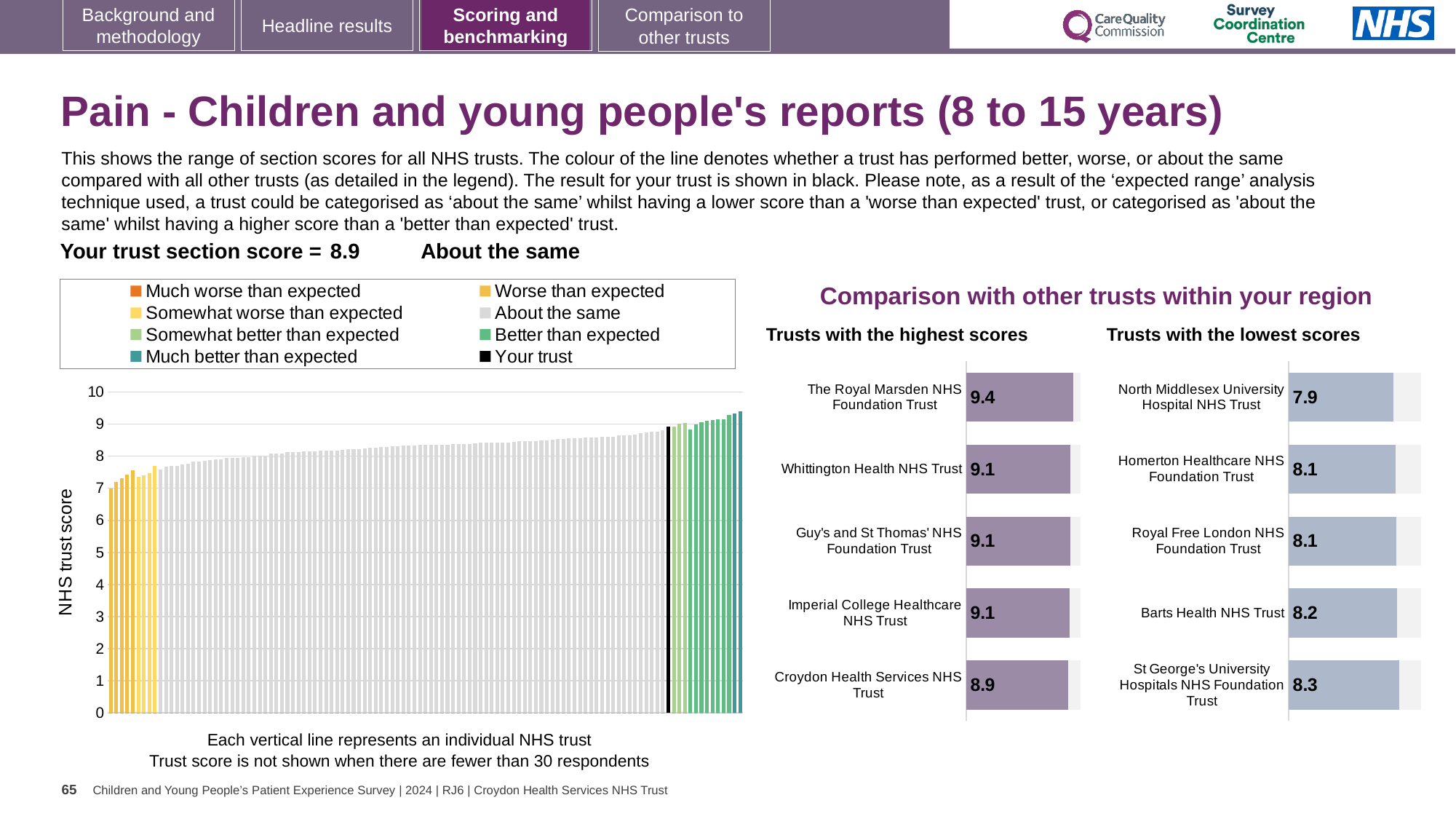
In the left-hand chart of NHS trust scores, how many entries does the legend list? 8 In the 'Trusts with the lowest scores' chart, which has the larger score: Barts Health NHS Trust or Homerton Healthcare NHS Foundation Trust? Barts Health NHS Trust In the left-hand chart of NHS trust scores, do the values rise or fall from left to right along the x axis? rise In the 'Trusts with the lowest scores' chart, which trust has the lowest score? North Middlesex University Hospital NHS Trust In the 'Trusts with the highest scores' chart, what is the score for Croydon Health Services NHS Trust? 8.9 In the 'Trusts with the lowest scores' chart, which trust has the highest score? St George's University Hospitals NHS Foundation Trust In the 'Trusts with the lowest scores' chart, what is the difference between the scores of St George's University Hospitals NHS Foundation Trust and North Middlesex University Hospital NHS Trust? 0.4 In the 'Trusts with the highest scores' chart, what is the score for The Royal Marsden NHS Foundation Trust? 9.4 In the 'Trusts with the lowest scores' chart, what is the score for North Middlesex University Hospital NHS Trust? 7.9 In the 'Trusts with the highest scores' chart, which trust has the highest score? The Royal Marsden NHS Foundation Trust In the 'Trusts with the highest scores' chart, what is the difference between the scores of The Royal Marsden NHS Foundation Trust and Croydon Health Services NHS Trust? 0.5 In the 'Trusts with the highest scores' chart, how many trusts are shown? 5